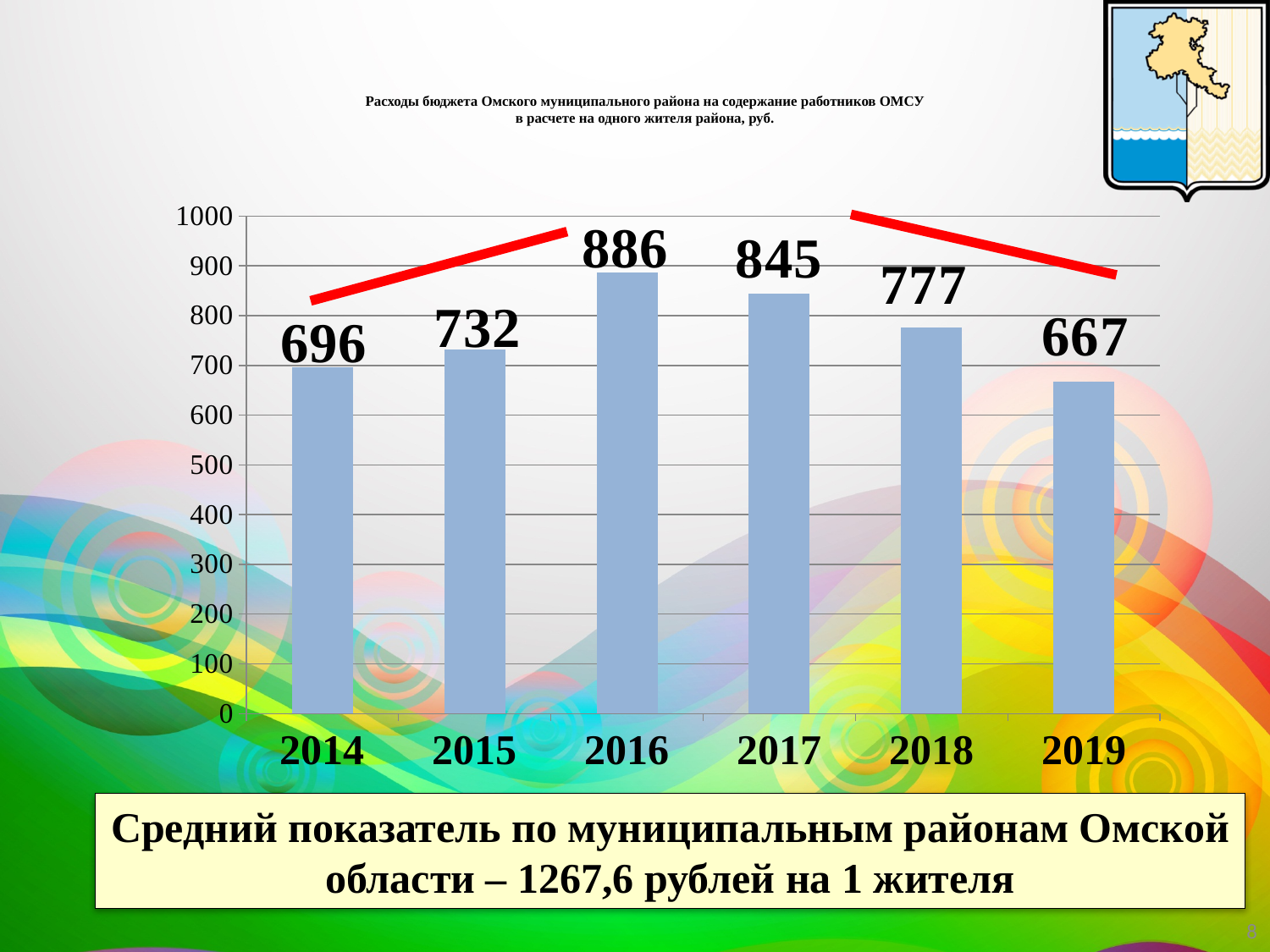
What is the difference between the values for 2016 and 2019? 219 Which year has the lowest value? 2019 What kind of chart is shown on the slide? bar chart What is the difference between the values for 2015 and 2014? 36 How many years are shown on the x axis? 6 What is the value for 2019? 667 What is the value for 2014? 696 Which is larger, the value for 2017 or the value for 2018? 2017 Do the values rise or fall from 2016 to 2019? fall What is the value for 2016? 886 Is the value for 2018 greater or less than 800? less Which year has the highest value? 2016